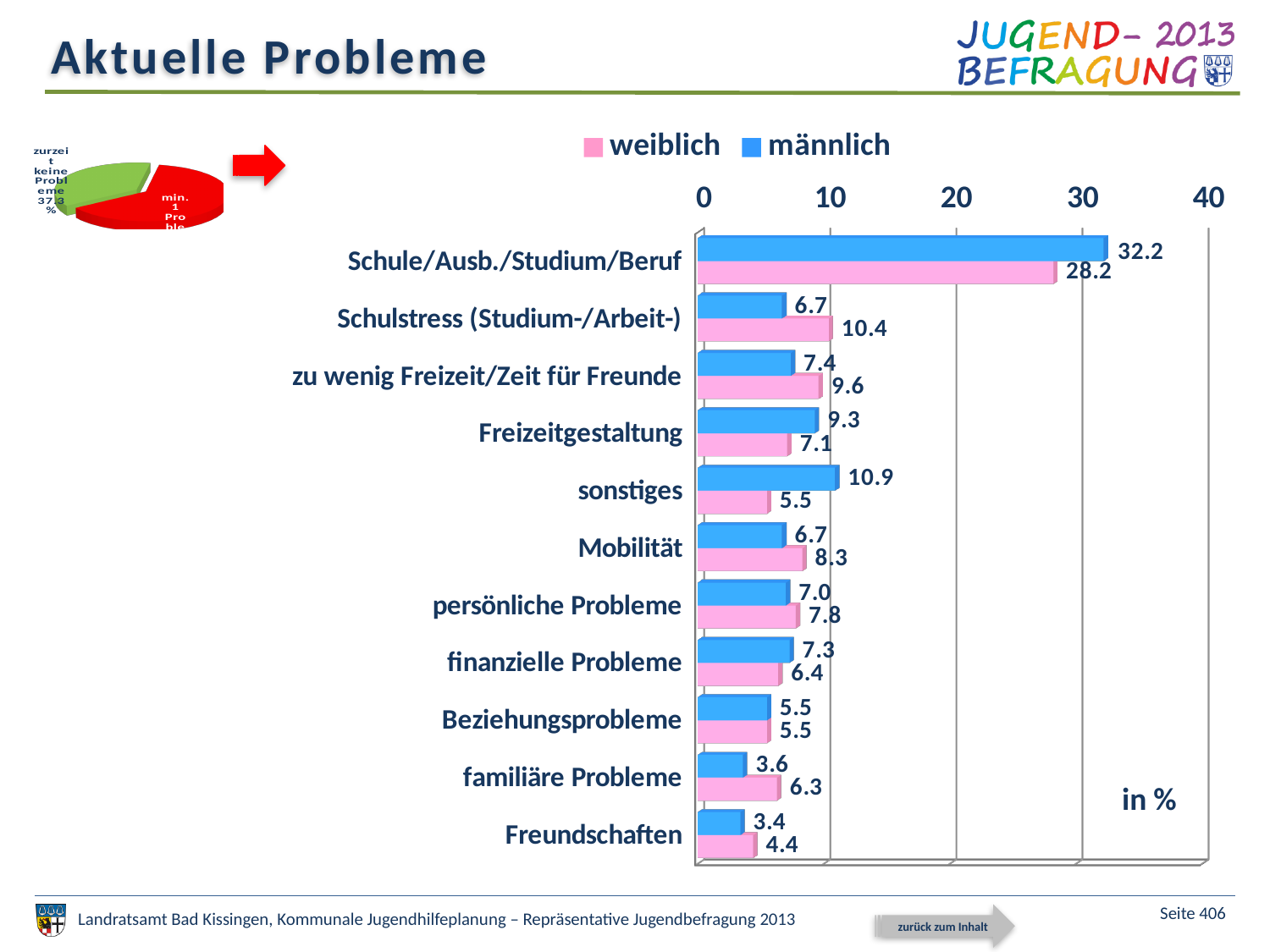
In the bar chart, is the männlich value for Schule/Ausb./Studium/Beruf greater or less than 30? greater How many categories does the bar chart show? 11 In the bar chart, what is the value for männlich for Schule/Ausb./Studium/Beruf? 32.2 In the bar chart, which category has the highest value for weiblich? Schule/Ausb./Studium/Beruf In the bar chart, what is the value for weiblich for Schulstress (Studium-/Arbeit-)? 10.4 In the bar chart, which is larger for Mobilität: the weiblich value or the männlich value? weiblich How many series does the legend of the bar chart list? 2 In the bar chart, which category has the lowest value for männlich? Freundschaften In the bar chart, what is the value for weiblich for familiäre Probleme? 6.3 In the bar chart, what is the difference between the männlich and weiblich values for Schule/Ausb./Studium/Beruf? 4.0 In the bar chart, what is the difference between the männlich and weiblich values for sonstiges? 5.4 What type of chart is the large chart on the right side of the slide? bar chart